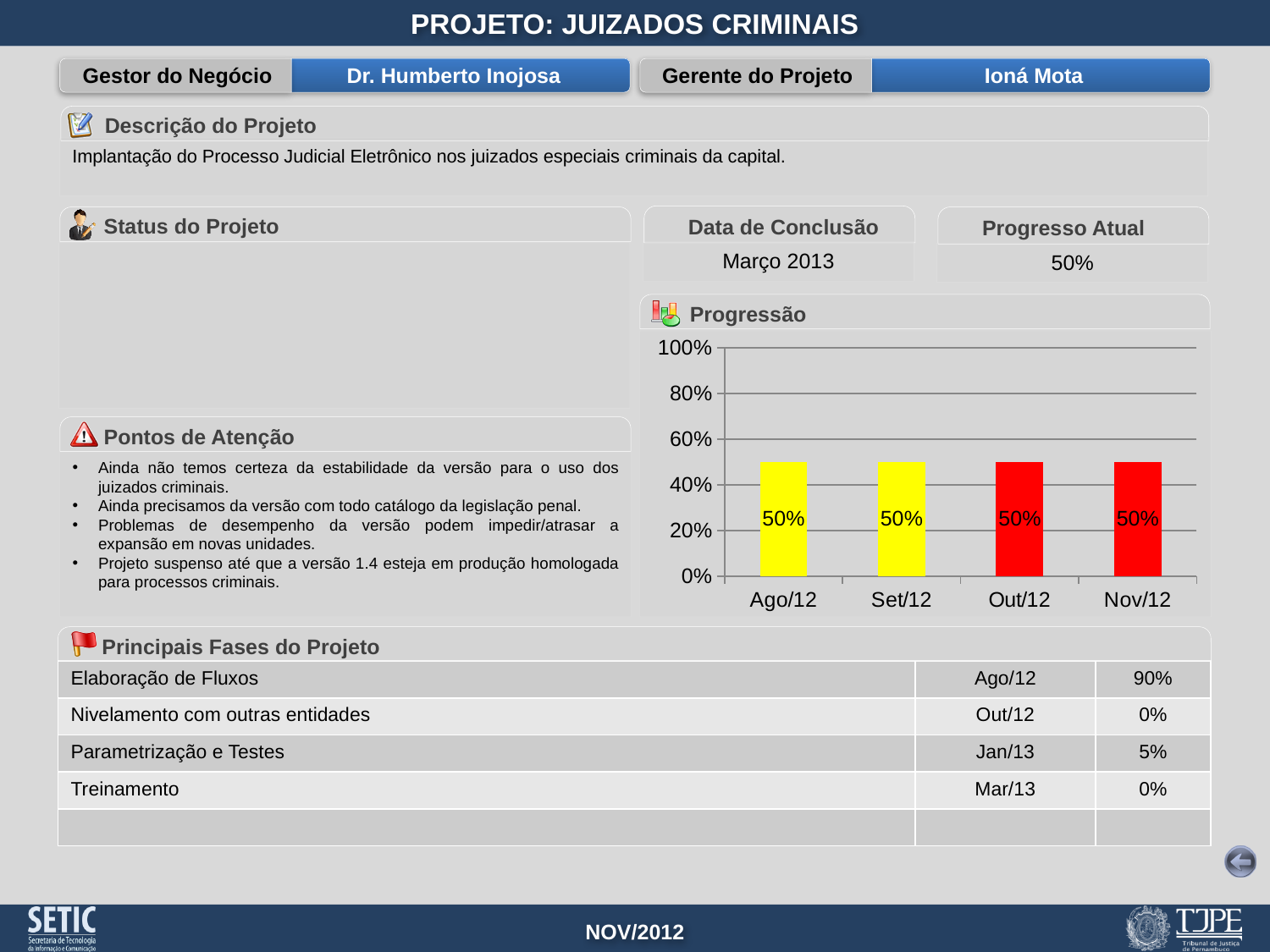
What is the value for Nov/12 in the Progressão chart? 50% What colour are the bars for Out/12 and Nov/12 in the Progressão chart? red What is the difference between the values for Ago/12 and Nov/12 in the Progressão chart? 0% What is the title of the chart on the slide? Progressão Is the value for Set/12 in the Progressão chart greater or less than 20%? greater What is the value for Set/12 in the Progressão chart? 50% Do the values in the Progressão chart rise, fall or stay the same from Ago/12 to Nov/12? stay the same Is the value for Out/12 in the Progressão chart greater or less than 80%? less How many categories are shown on the x axis of the Progressão chart? 4 What is the value for Out/12 in the Progressão chart? 50% What kind of chart is the Progressão chart? bar chart What is the value for Ago/12 in the Progressão chart? 50%